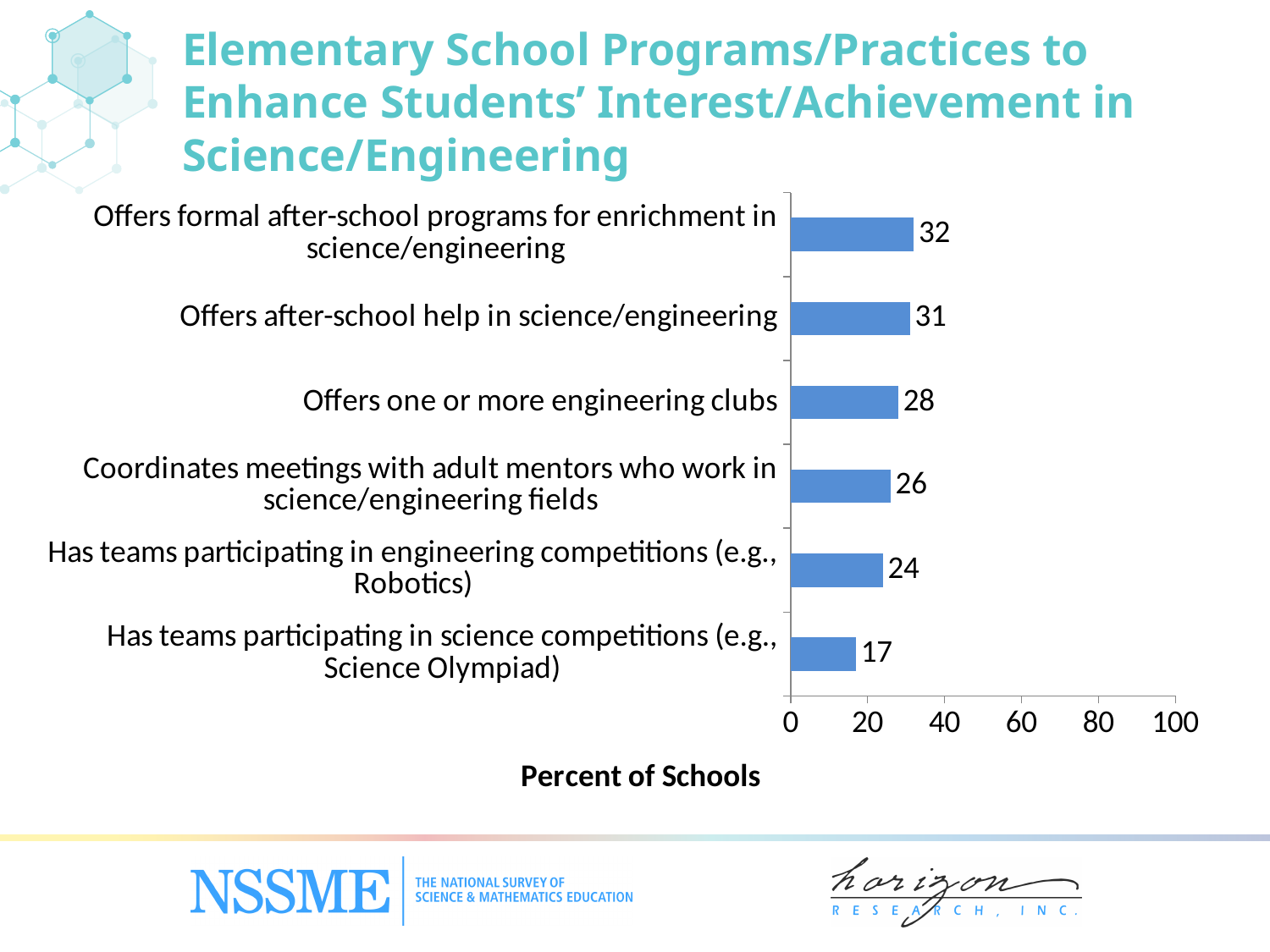
Which program/practice has the lowest percent of schools? Has teams participating in science competitions (e.g., Science Olympiad) What kind of chart is shown on the slide? bar chart What percent of schools have teams participating in science competitions (e.g., Science Olympiad)? 17 Which program/practice has the highest percent of schools? Offers formal after-school programs for enrichment in science/engineering What is the difference in percent of schools between 'Has teams participating in engineering competitions (e.g., Robotics)' and 'Has teams participating in science competitions (e.g., Science Olympiad)'? 7 What is the label of the horizontal axis? Percent of Schools Is the value for 'Coordinates meetings with adult mentors who work in science/engineering fields' greater or less than 40? less How many programs/practices are shown in the chart? 6 What is the maximum value shown on the horizontal axis? 100 What is the value for 'Offers one or more engineering clubs'? 28 What percent of schools offer formal after-school programs for enrichment in science/engineering? 32 Which is larger: the value for 'Offers after-school help in science/engineering' or the value for 'Coordinates meetings with adult mentors who work in science/engineering fields'? Offers after-school help in science/engineering